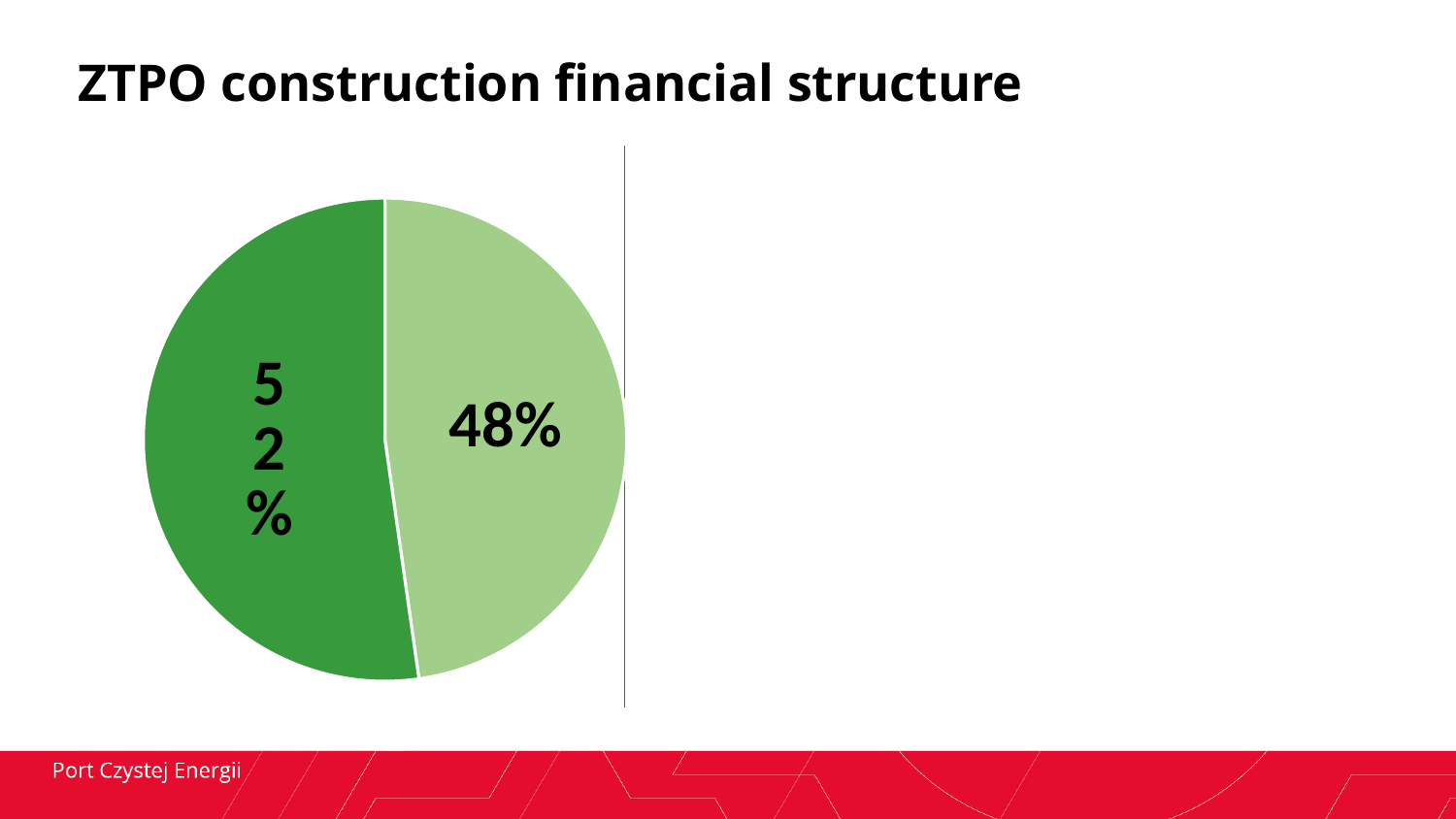
Is the share of the light green slice greater or less than 50%? less Is the share of the dark green slice greater or less than 50%? greater What share of the pie does the dark green slice represent? 52% Which slice of the pie is the largest? the dark green slice (52%) How many slices does the pie chart have? 2 Which slice is larger, the dark green one or the light green one? the dark green one What is the difference in percentage points between the two slices of the pie? 4 percentage points Which slice of the pie is the smallest? the light green slice (48%) Does the pie chart include a legend naming the slices? No What kind of chart is shown on the slide? pie chart What share of the pie does the light green slice represent? 48% What is the title of the slide containing the pie chart? ZTPO construction financial structure